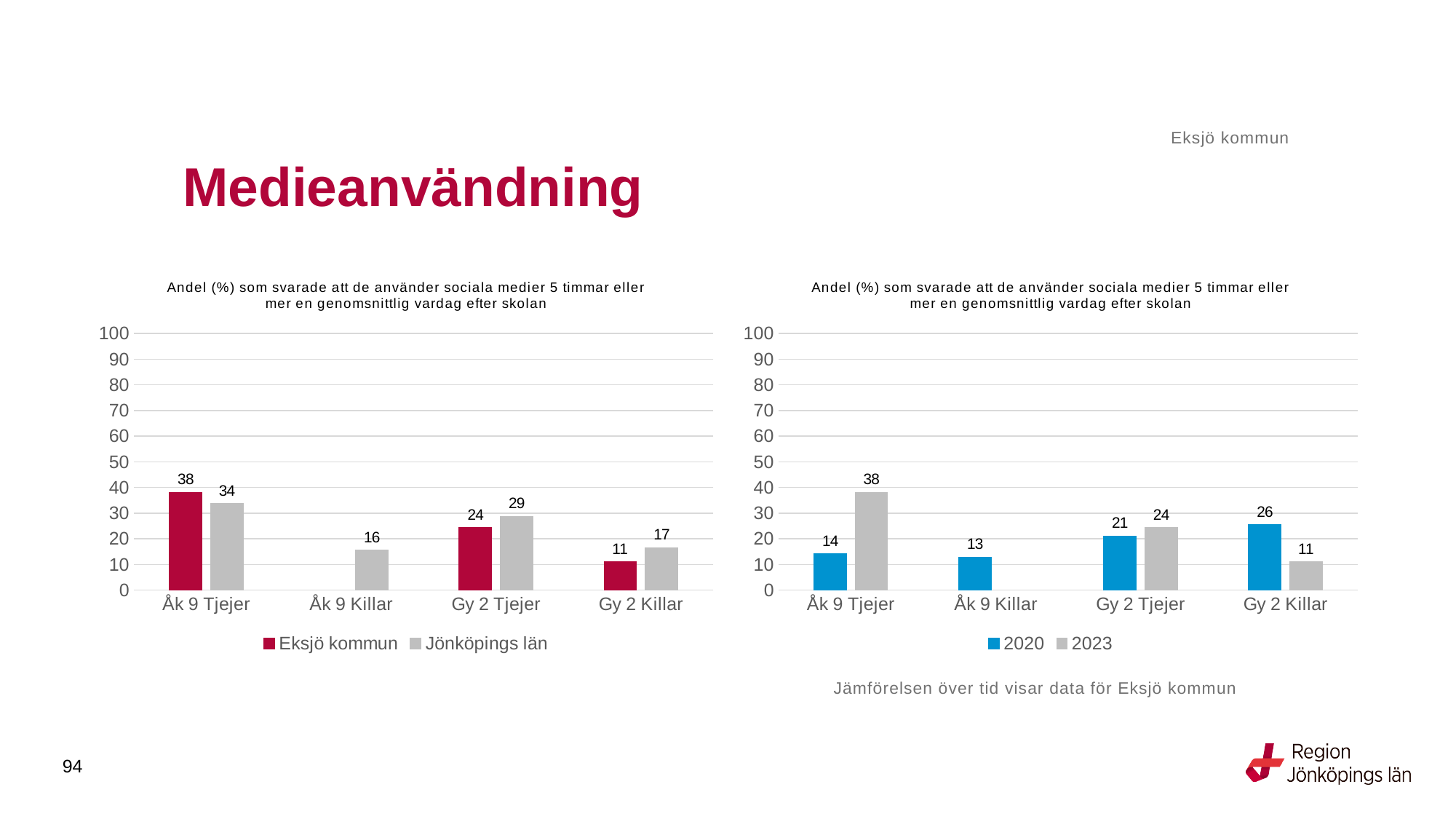
In the right chart, what is the difference between 2023 and 2020 for Åk 9 Tjejer? 24 In the right chart, how many categories are shown on the x axis? 4 In the left chart, which category has the highest value for Jönköpings län? Åk 9 Tjejer In the left chart, how many series does the legend list? 2 In the left chart, which is larger for Gy 2 Killar: Eksjö kommun or Jönköpings län? Jönköpings län In the right chart, what is the value for 2023 for Åk 9 Tjejer? 38 In the right chart, what is the value for 2020 for Gy 2 Killar? 26 In the left chart, what is the difference between Jönköpings län and Eksjö kommun for Gy 2 Tjejer? 5 In the left chart, what is the value for Eksjö kommun for Åk 9 Tjejer? 38 In the right chart, which category has the lowest value for 2020? Åk 9 Killar In the left chart, what is the value for Jönköpings län for Gy 2 Killar? 17 What kind of chart is the right chart? Bar chart